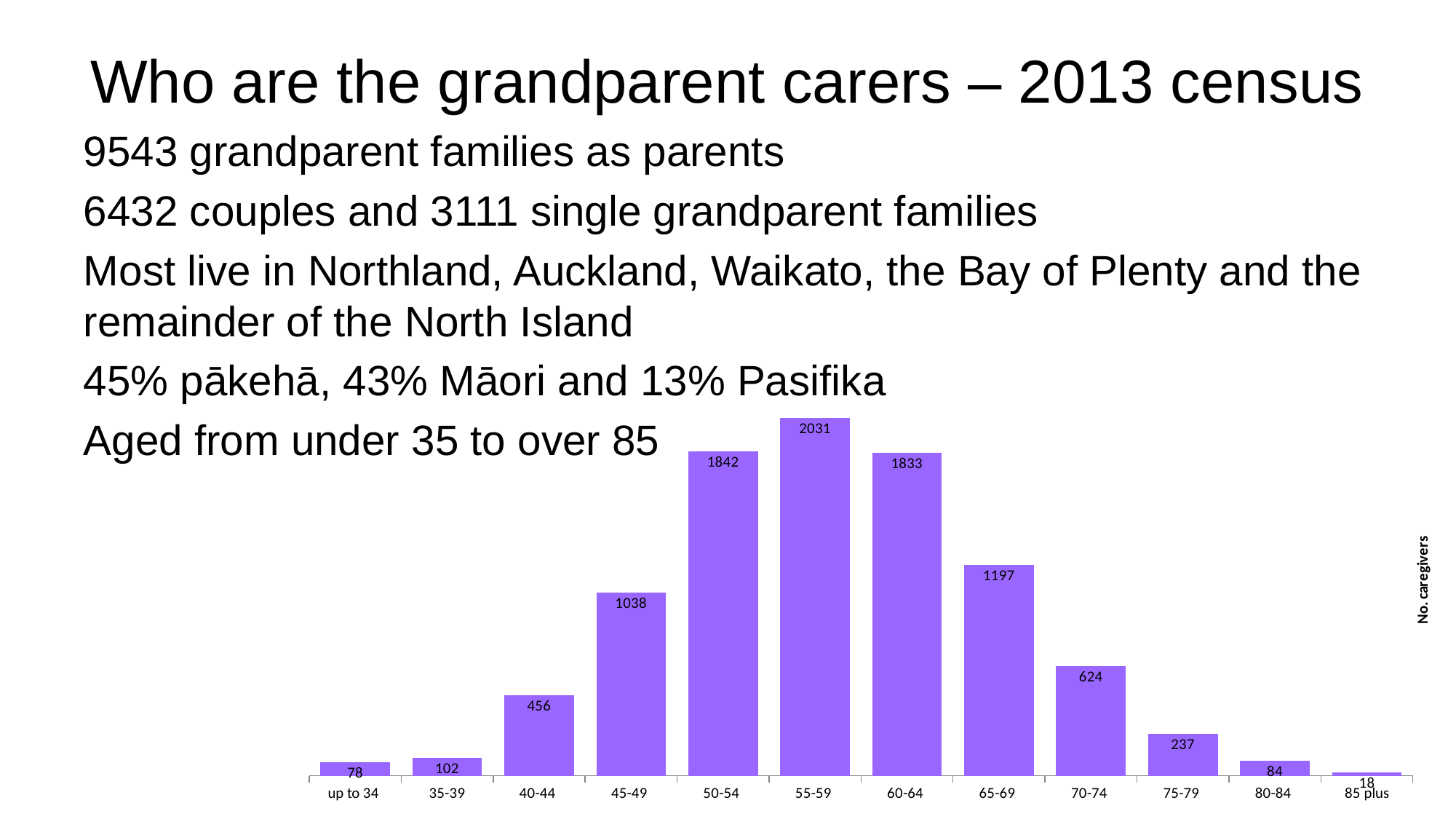
What is the difference in the number of caregivers between the 65-69 and 70-74 age groups? 573 Which age group has the lowest number of caregivers? 85 plus What is the number of caregivers in the 45-49 age group? 1038 What is the number of caregivers in the 70-74 age group? 624 How many age groups are shown in the chart? 12 Which age group has the highest number of caregivers? 55-59 What is the number of caregivers in the 85 plus age group? 18 Which age group has more caregivers, 40-44 or 75-79? 40-44 What is the difference in the number of caregivers between the 55-59 and 60-64 age groups? 198 What is the number of caregivers in the 55-59 age group? 2031 What is the label on the vertical axis of the chart? No. caregivers What type of chart is shown on the slide? Bar chart